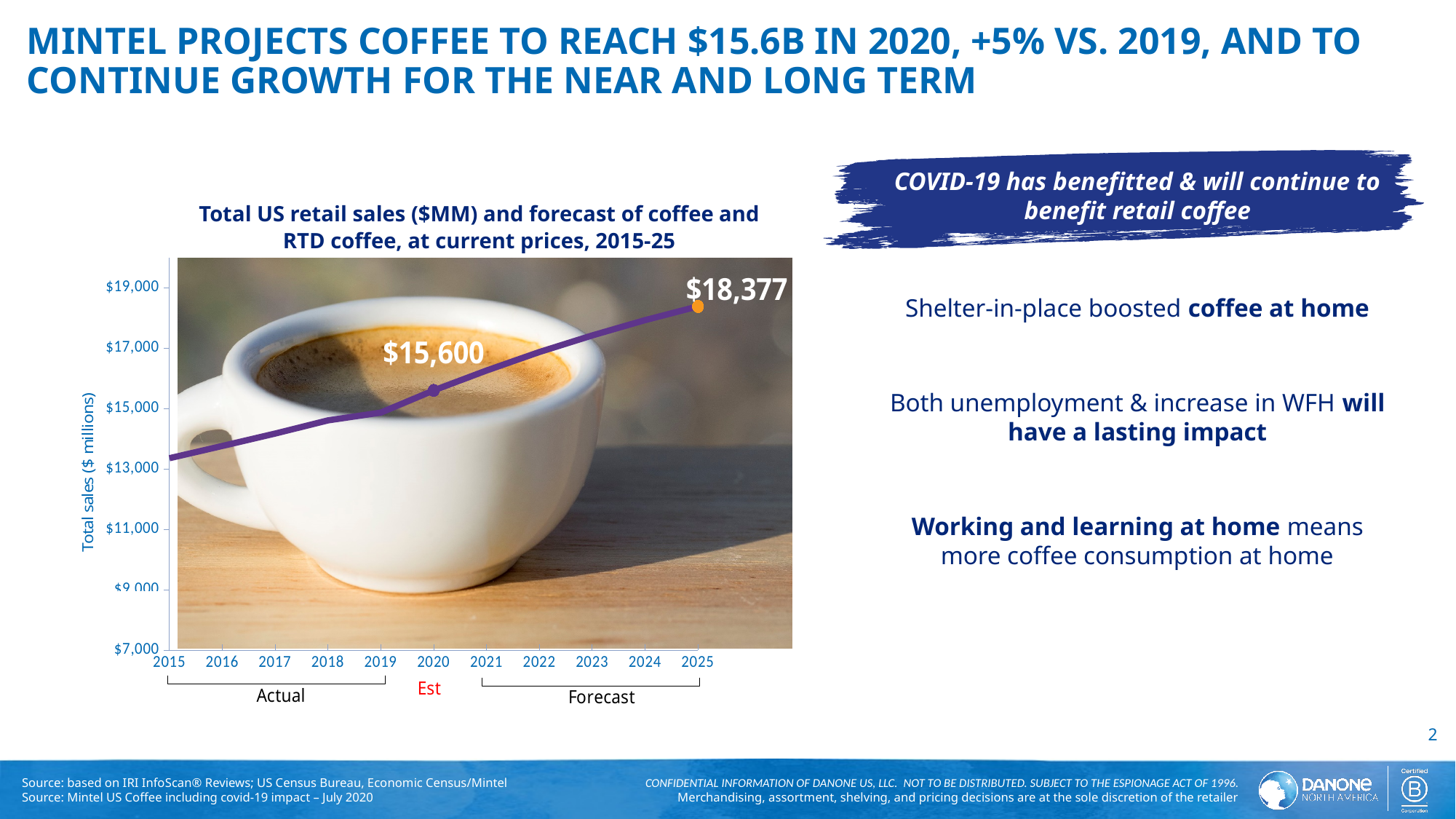
Is the value for 2022 greater or less than $15,000? greater Do the values on the chart rise or fall from 2015 to 2025? rise Which year has the highest value on the chart? 2025 Which year has the larger value on the chart, 2020 or 2025? 2025 Which year has the lowest value on the chart? 2015 What is the difference between the 2025 value and the 2020 value on the chart? $2,777 Which years on the chart are bracketed as 'Actual'? 2015 to 2019 What is the value plotted for 2020 on the chart? $15,600 What kind of chart is shown on the slide? line chart How many years are shown on the x axis of the chart? 11 Is the value for 2017 greater or less than $15,000? less What is the value plotted for 2025 on the chart? $18,377